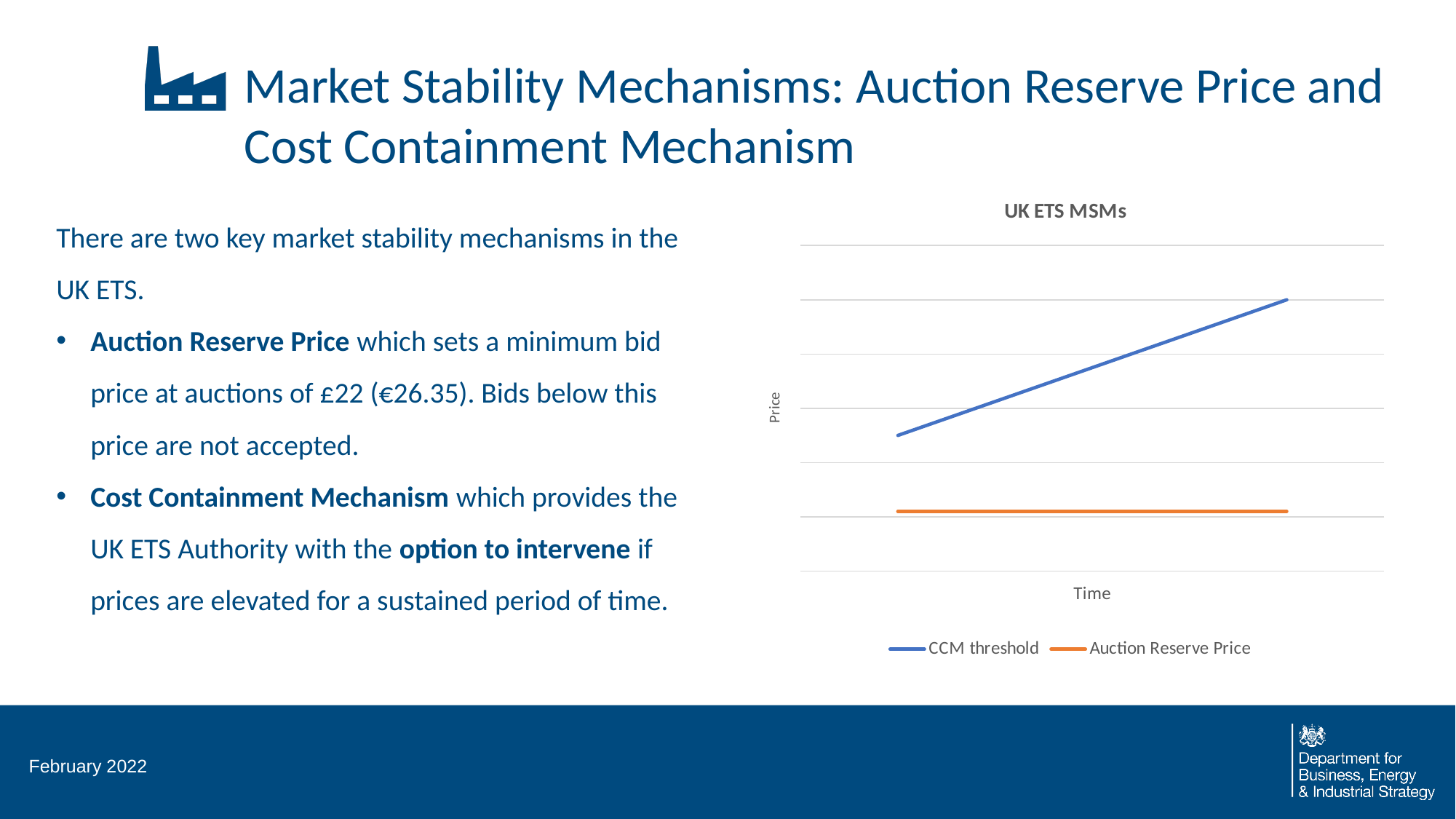
In the UK ETS MSMs chart, which series is plotted higher on the price axis, CCM threshold or Auction Reserve Price? CCM threshold In the UK ETS MSMs chart, which series has the highest values? CCM threshold What is the title of the chart on the slide? UK ETS MSMs What label is shown on the horizontal axis of the UK ETS MSMs chart? Time What kind of chart is shown on the slide? line chart In the UK ETS MSMs chart, which series has the lowest values? Auction Reserve Price In the UK ETS MSMs chart, does the CCM threshold line rise or fall over time? rise In the UK ETS MSMs chart, does the Auction Reserve Price line rise, fall or stay flat over time? stay flat How many series does the legend of the UK ETS MSMs chart list? 2